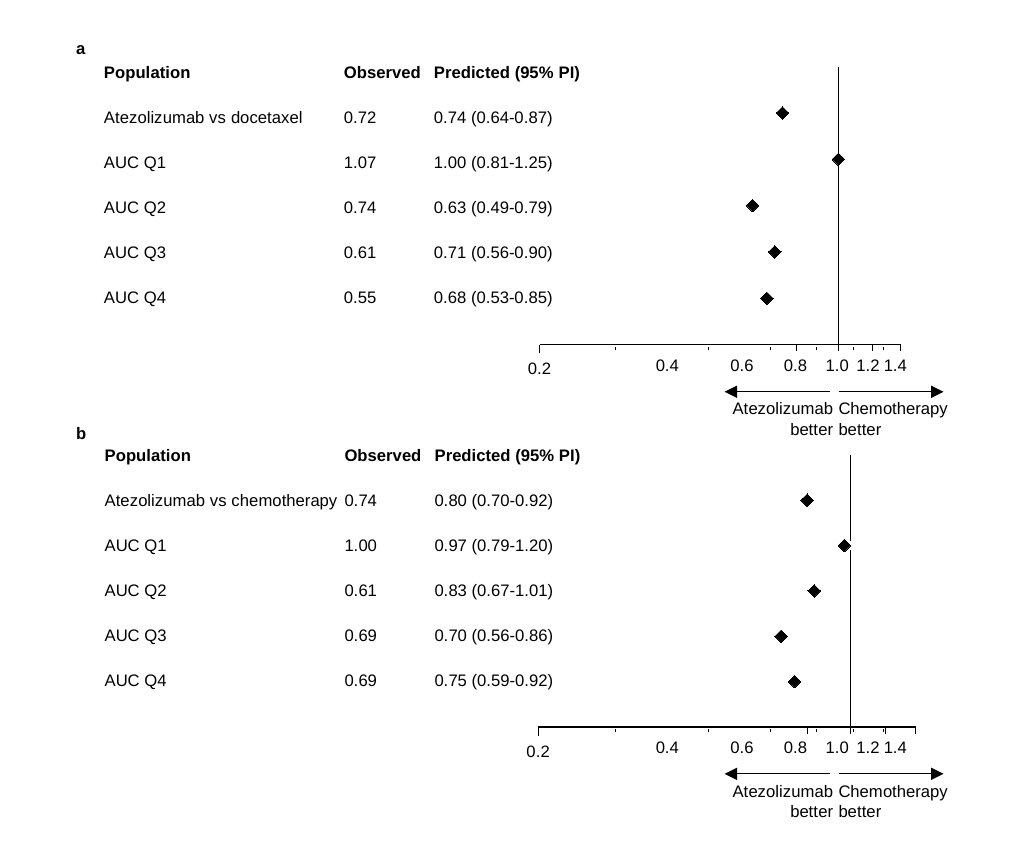
In panel b, what is the difference between the predicted values for AUC Q1 and AUC Q3? 0.27 In panel b, which population has the lowest predicted value? AUC Q3 In panel b, is the predicted value for AUC Q2 greater or less than 1.0? less In panel a, what is the predicted hazard ratio plotted for AUC Q2? 0.63 In panel a, which population has the lowest predicted value? AUC Q2 According to the axis annotation in panel b, which treatment is favoured by values to the left of the vertical line? Atezolizumab In panel a, which has the larger predicted value, AUC Q3 or AUC Q4? AUC Q3 In panel b, what is the observed value for Atezolizumab vs chemotherapy? 0.74 How many populations are plotted in panel a? 5 In panel a, what is the 95% PI for the predicted value of AUC Q4? 0.53-0.85 In panel a, which population has the highest predicted value? AUC Q1 In panel b, what is the predicted value plotted for AUC Q3? 0.70